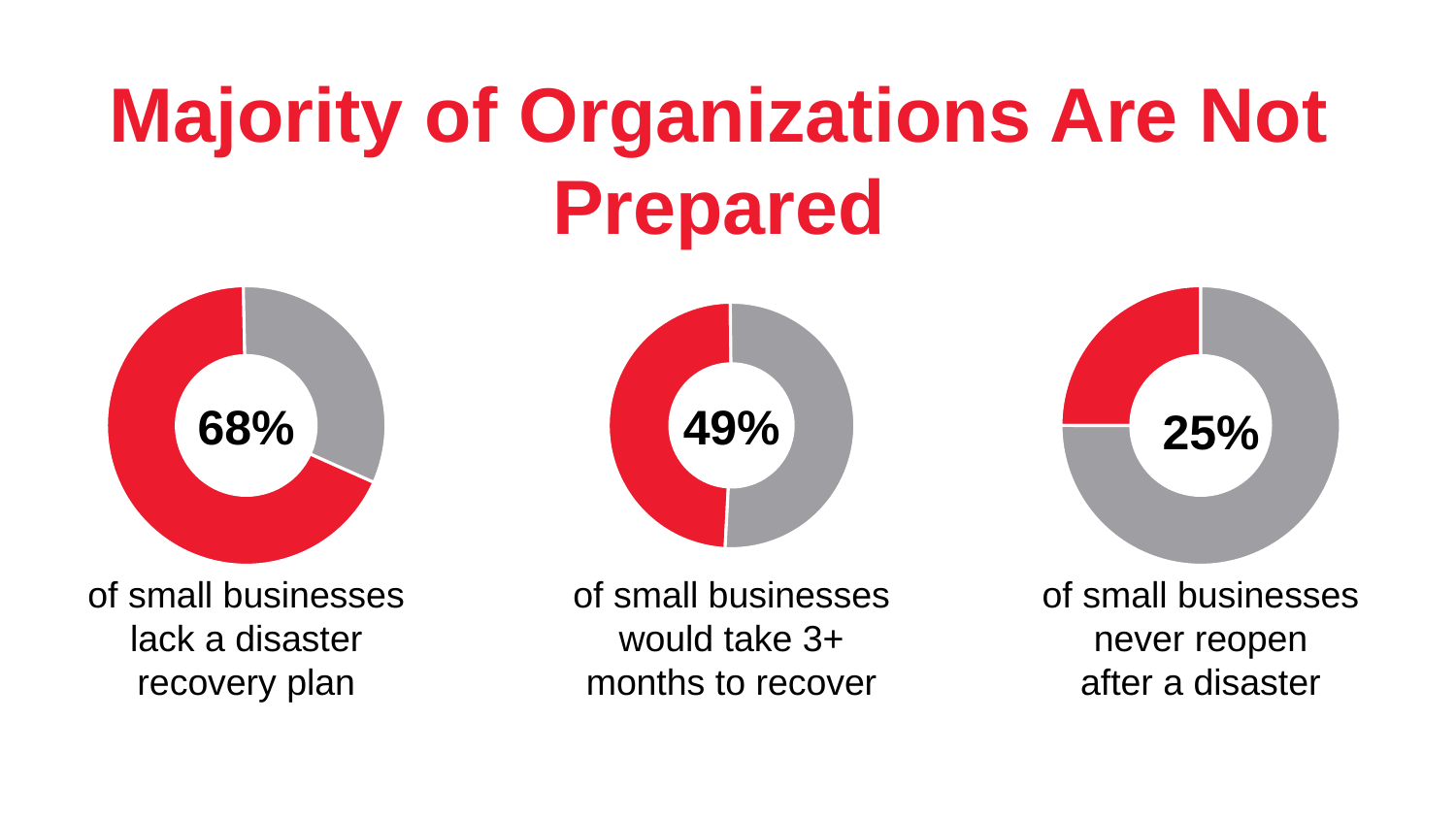
Which of the three charts shows the highest percentage? The left chart (lack a disaster recovery plan), 68% What percentage of small businesses would take 3+ months to recover, according to the middle chart? 49% Which of the three charts shows the lowest percentage? The right chart (never reopen after a disaster), 25% How many donut charts are shown on the slide? 3 Which is larger: the percentage of small businesses that would take 3+ months to recover, or the percentage that never reopen after a disaster? Would take 3+ months to recover (49%) What percentage of small businesses never reopen after a disaster, according to the right chart? 25% In the right chart, what share of the donut is filled in red? 25% What kind of chart is used for each of the three statistics on the slide? Donut (pie) chart What percentage of small businesses lack a disaster recovery plan, according to the left chart? 68% What is the difference between the percentage in the left chart (68%) and the percentage in the middle chart (49%)? 19 percentage points What is the difference between the percentage in the left chart (68%) and the percentage in the right chart (25%)? 43 percentage points What is the title of the slide? Majority of Organizations Are Not Prepared